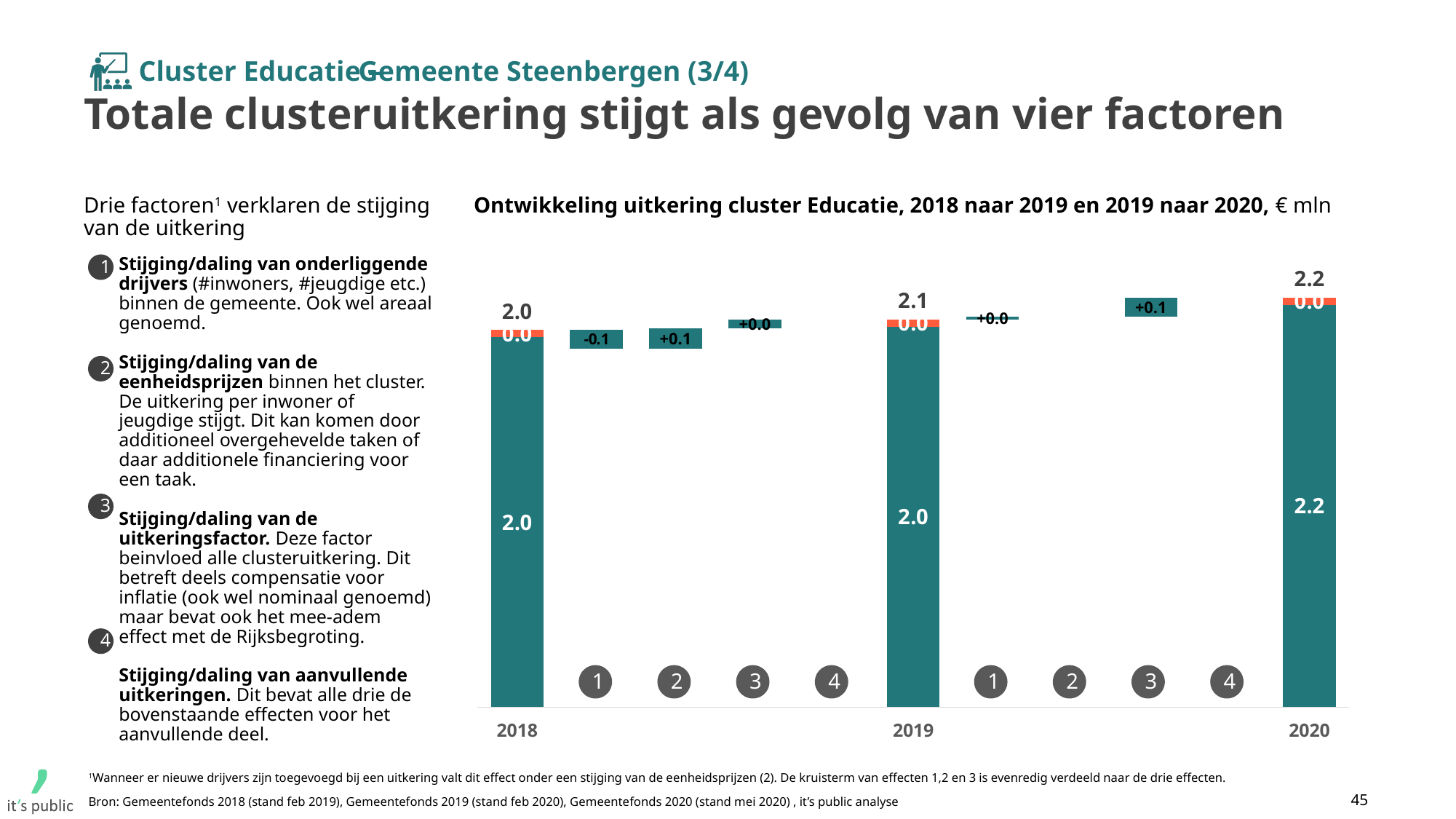
Which year has the lowest total uitkering? 2018 What is the total uitkering for cluster Educatie in 2019? 2.1 What is the value of factor 2 in the change from 2018 to 2019? +0.1 What is the total uitkering for cluster Educatie in 2020? 2.2 What is the value of factor 3 in the change from 2019 to 2020? +0.1 Does the total uitkering rise or fall from 2018 to 2020? rise What is the difference between the total uitkering in 2020 and in 2018? 0.2 What is the value of factor 1 in the change from 2018 to 2019? -0.1 Which year has the highest total uitkering? 2020 What is the total uitkering for cluster Educatie in 2018? 2.0 In what unit are the values in the chart expressed? € mln Which is larger, the total uitkering in 2019 or in 2018? 2019